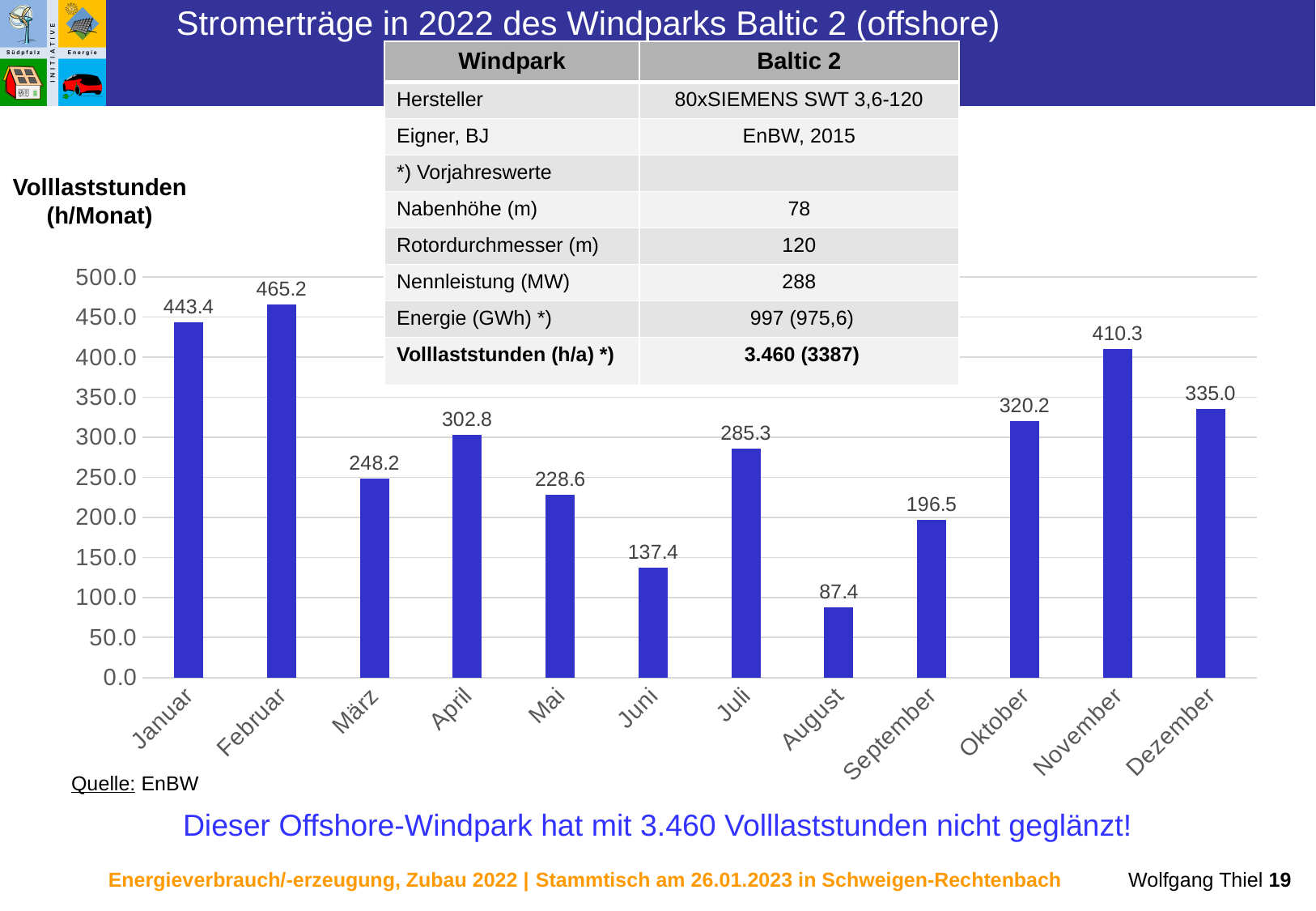
Is the value for Dezember greater or less than 300.0? greater How many months are shown on the x axis of the chart? 12 What is the difference between the values for Januar and Februar? 21.8 What is the y-axis label of the chart? Volllaststunden (h/Monat) What is the value for November in the chart? 410.3 Which is larger, the value for April or the value for Juli? April Which month has the lowest value in the chart? August What kind of chart is shown on the slide? bar chart What is the value for August in the chart? 87.4 Which month has the highest value in the chart? Februar What is the difference between the values for Oktober and September? 123.7 What is the value for Februar in the chart? 465.2